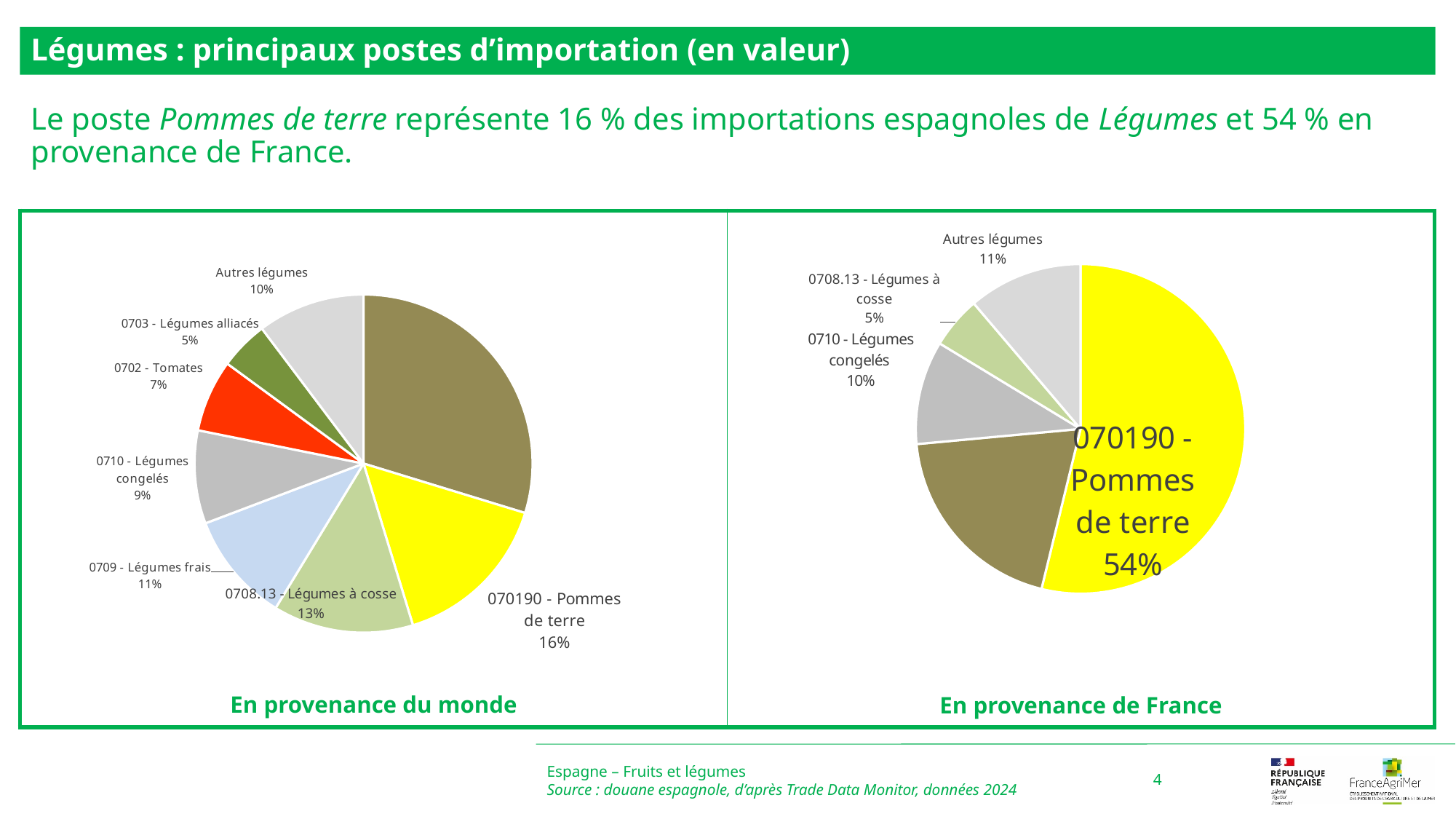
In the pie chart 'En provenance du monde', what is the difference in share between '0708.13 - Légumes à cosse' and '0702 - Tomates'? 6 percentage points In the pie chart 'En provenance du monde', which labelled category has the smallest share? 0703 - Légumes alliacés In the pie chart 'En provenance du monde', what is the share of '0702 - Tomates'? 7% In the pie chart 'En provenance du monde', what is the share of '0709 - Légumes frais'? 11% In the pie chart 'En provenance du monde', which has the larger share: '0708.13 - Légumes à cosse' or '0710 - Légumes congelés'? 0708.13 - Légumes à cosse What type of chart is used on this slide? Pie chart In the pie chart 'En provenance de France', which category has the largest share? 070190 - Pommes de terre In the pie chart 'En provenance de France', what is the share of 'Autres légumes'? 11% In the pie chart 'En provenance de France', what share does '070190 - Pommes de terre' represent? 54% How many percentage points higher is the share of '070190 - Pommes de terre' in the 'En provenance de France' chart than in the 'En provenance du monde' chart? 38 percentage points In the pie chart 'En provenance de France', what is the share of '0710 - Légumes congelés'? 10% In the pie chart 'En provenance du monde', what share does '070190 - Pommes de terre' represent? 16%